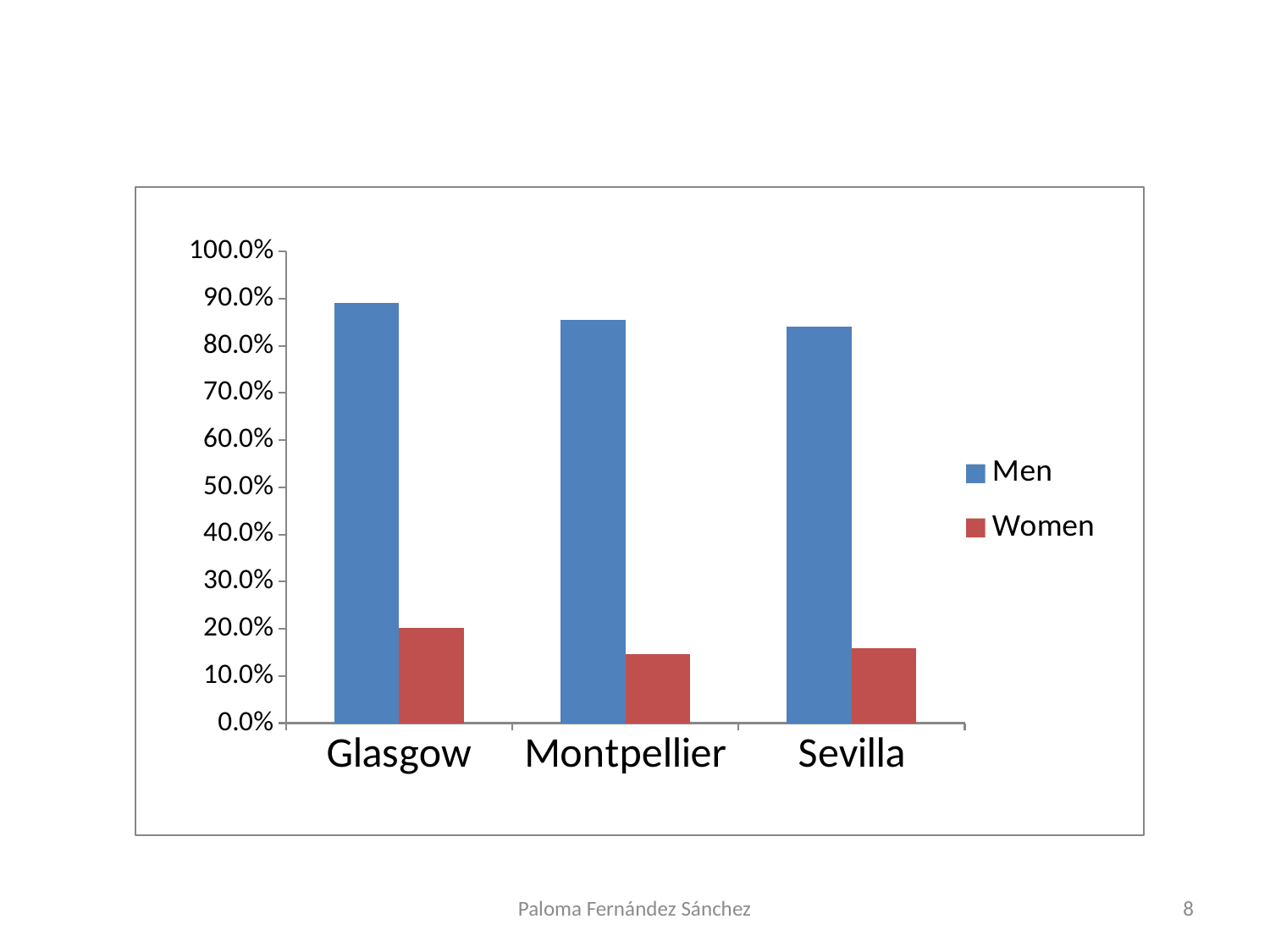
How many cities are shown on the x axis? 3 Is the value for Men in Glasgow greater or less than 80.0%? greater What kind of chart is shown on the slide? bar chart In Montpellier, which is larger, the value for Men or the value for Women? Men Which city has the highest value for Men? Glasgow Is the value for Men in Sevilla greater or less than 80.0%? greater Do the values for Men rise or fall from Glasgow to Sevilla along the x axis? fall Is the value for Women in Montpellier greater or less than 20.0%? less What colour are the bars for the Women series? red How many series does the legend list? 2 Which city has the highest value for Women? Glasgow